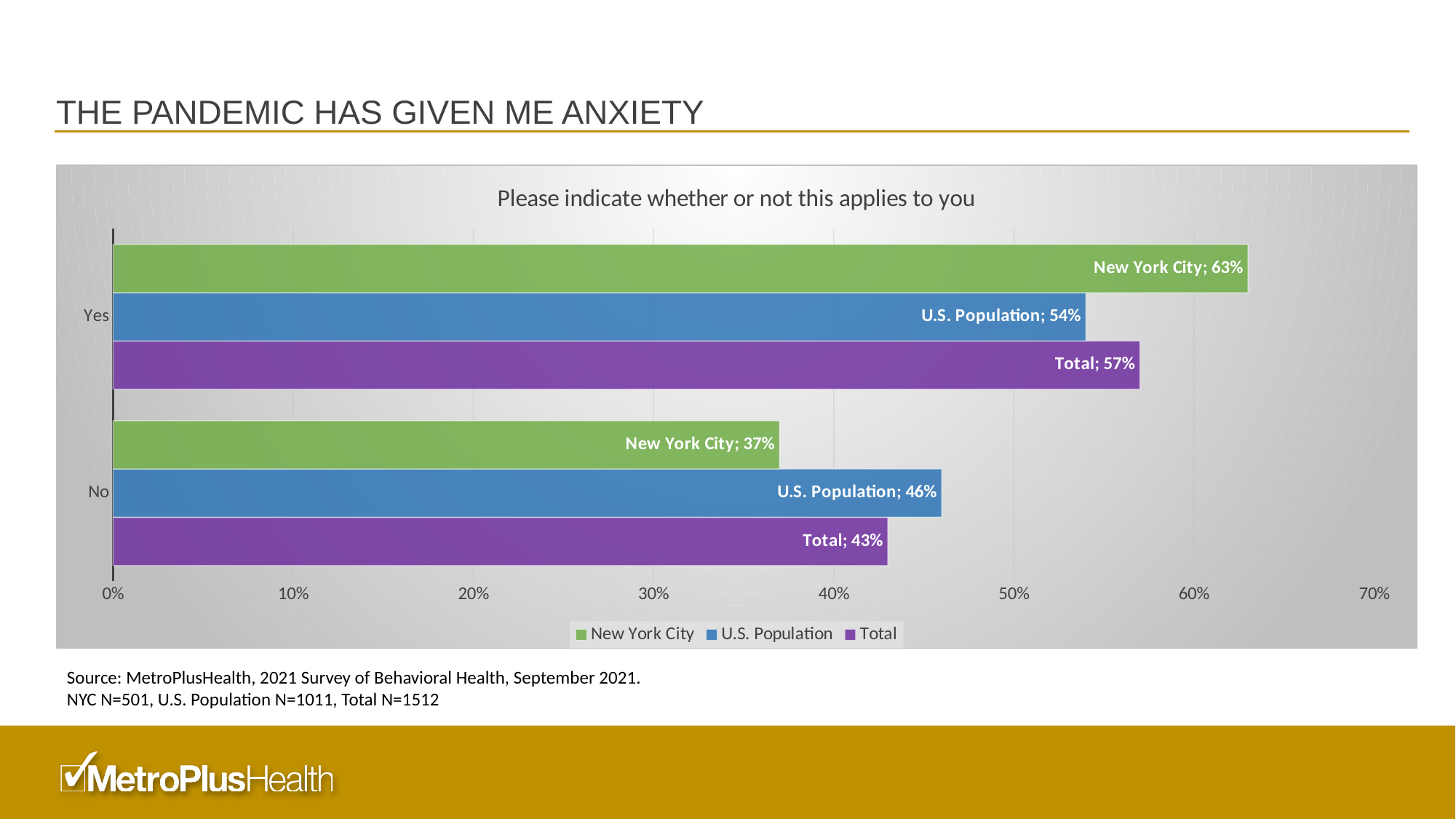
What percentage of New York City respondents answered Yes? 63% What is the Total value for Yes? 57% How many series does the legend list? 3 What is the difference between the New York City and U.S. Population values for Yes? 9% Is the U.S. Population value for Yes greater or less than 50%? greater Which series has the highest value in the Yes category? New York City What kind of chart is shown on the slide? Bar chart Which series has the lowest value in the No category? New York City How many categories are shown on the vertical axis? 2 Which is larger: the Total value for Yes or the Total value for No? Total value for Yes What is the U.S. Population value for the No category? 46% What colour are the Total bars? Purple